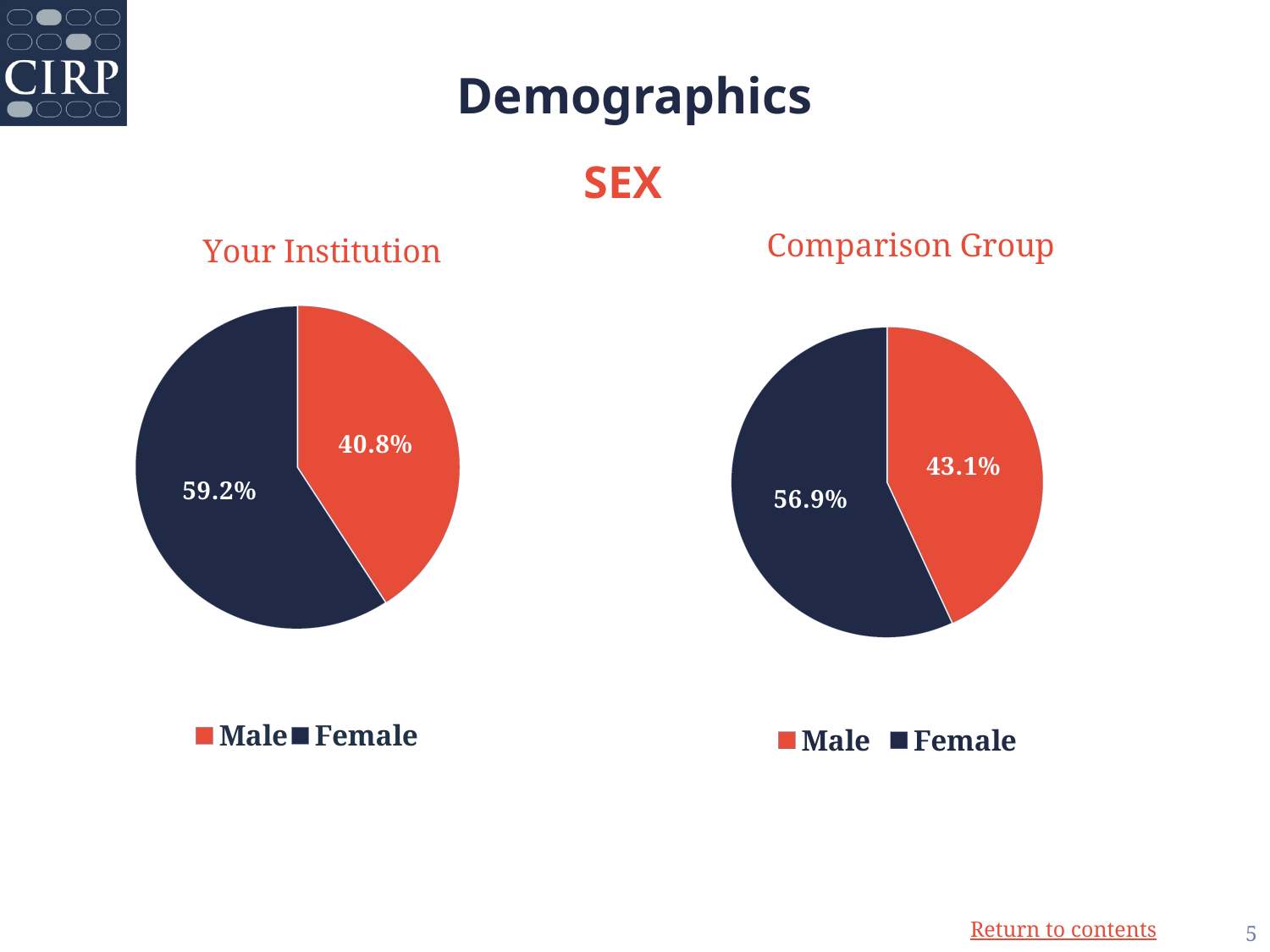
How many categories does the Comparison Group chart show? 2 Is the Male share larger in the Your Institution chart or the Comparison Group chart? Comparison Group What type of chart is used for the Your Institution data? Pie chart In the Comparison Group chart, what is the difference between the Female and Male shares? 13.8% In the Your Institution chart, what percentage is Male? 40.8% In the Your Institution chart, what is the difference between the Female and Male shares? 18.4% In the Comparison Group chart, which category has the smallest share? Male In the Your Institution chart, which category has the largest share? Female In the Your Institution chart, what colour represents Female? Dark navy blue In the Comparison Group chart, what percentage is Female? 56.9% In the Comparison Group chart, what percentage is Male? 43.1% In the Your Institution chart, what percentage is Female? 59.2%